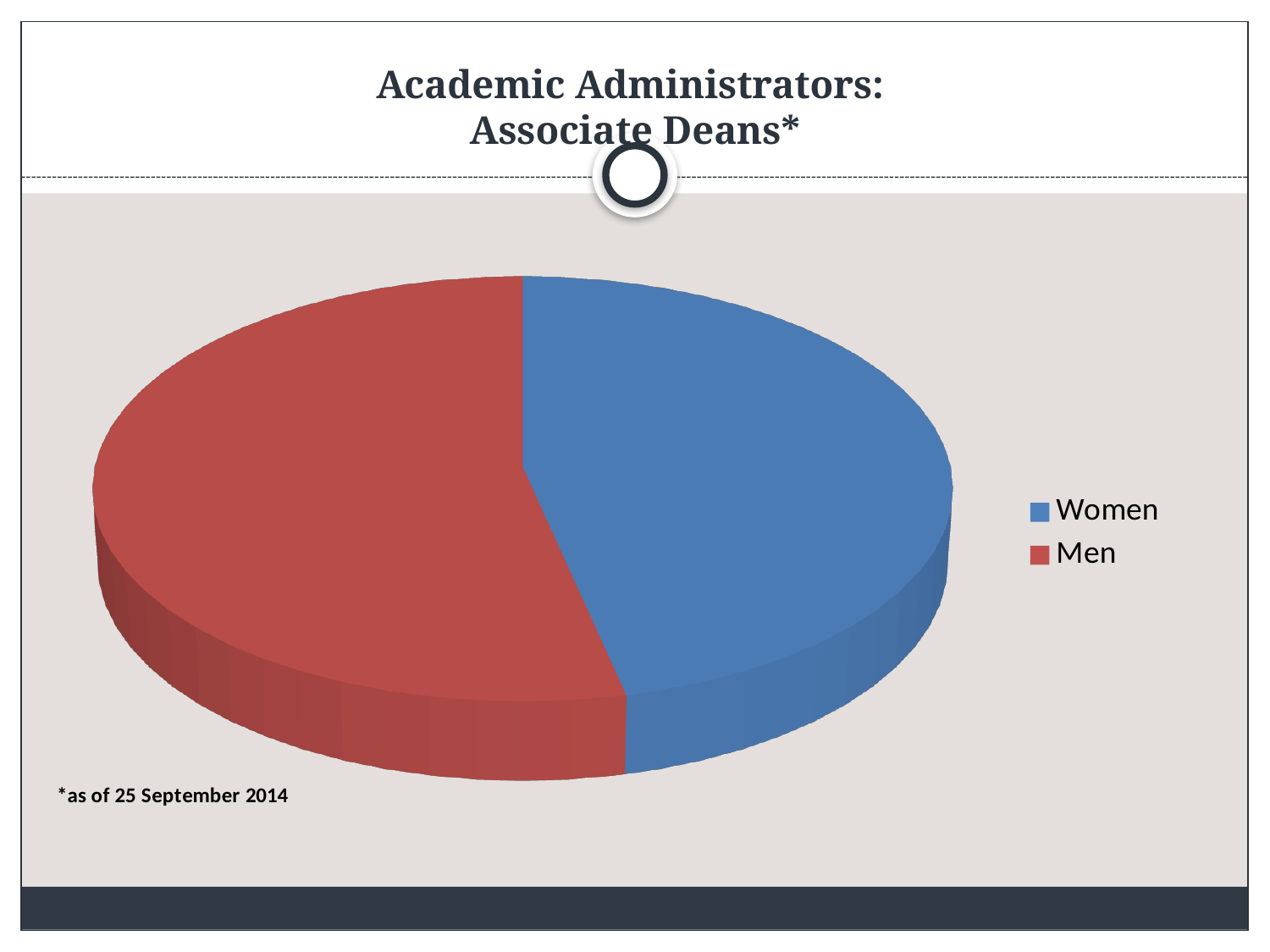
Which colour represents Women in the pie chart? blue Which slice is larger in the pie chart, Women or Men? Men Which category has the largest slice in the pie chart? Men How many entries does the legend of the pie chart list? 2 Which category has the smallest slice in the pie chart? Women What kind of chart is shown on the slide? pie chart What is the title of the chart on the slide? Academic Administrators: Associate Deans* How many slices does the pie chart have? 2